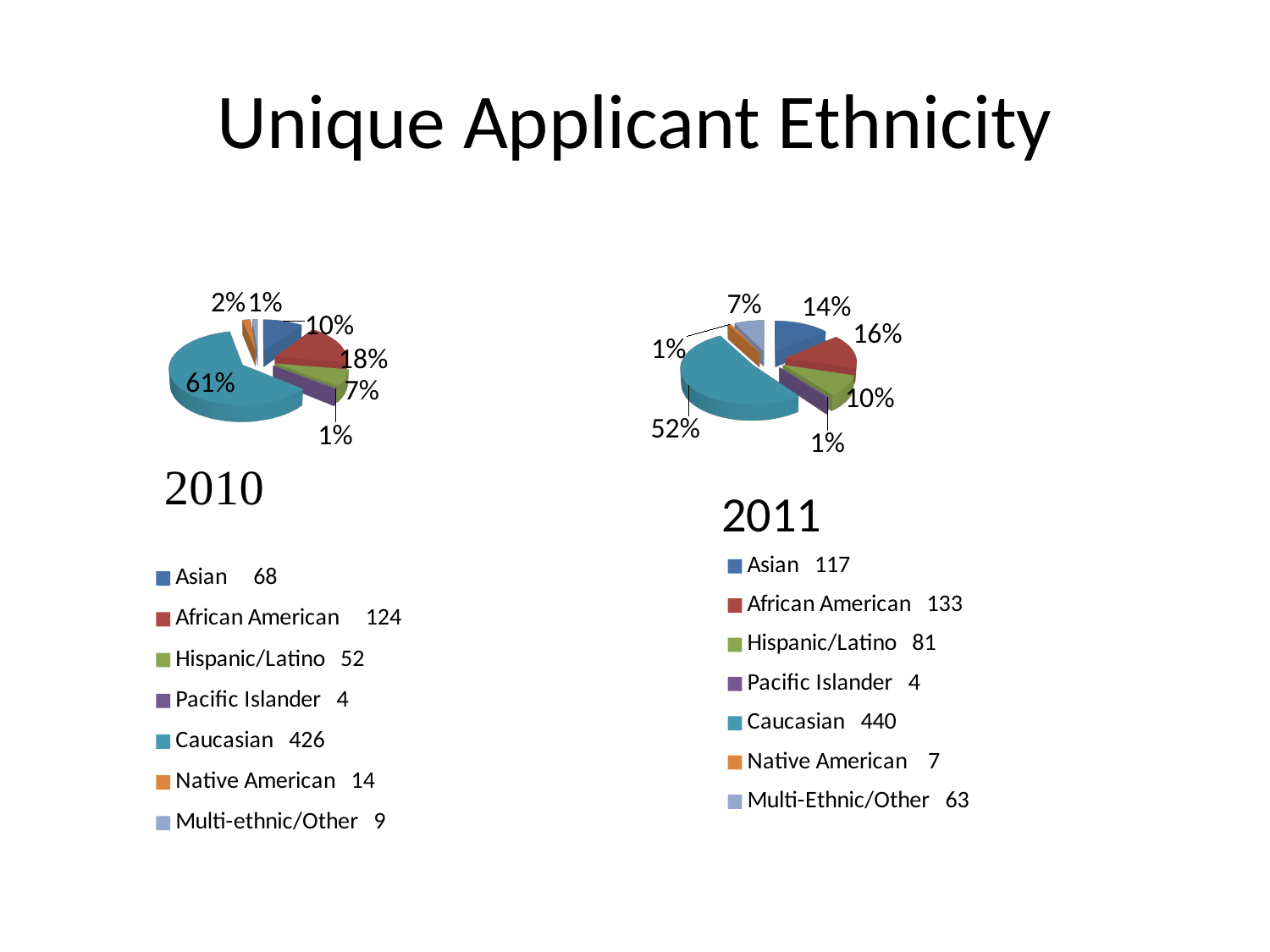
How many categories does the legend of the 2011 chart list? 7 In the 2010 chart, which is larger, the Asian count or the Hispanic/Latino count? Asian In the 2010 chart, which category has the smallest count in the legend? Pacific Islander In the 2011 chart, what is the difference between the Caucasian count and the African American count? 307 In the 2011 chart, what percentage of the pie does the Multi-Ethnic/Other slice represent? 7% What is the title of the slide? Unique Applicant Ethnicity In the 2011 chart, which category has the largest slice? Caucasian What type of charts are shown on the slide? Pie charts In the 2011 chart, what percentage of the pie does the Caucasian slice represent? 52% In the 2010 chart, what is the count shown in the legend for African American? 124 In the 2011 chart, what is the count shown in the legend for Asian? 117 In the 2010 chart, what percentage of the pie does the Caucasian slice represent? 61%